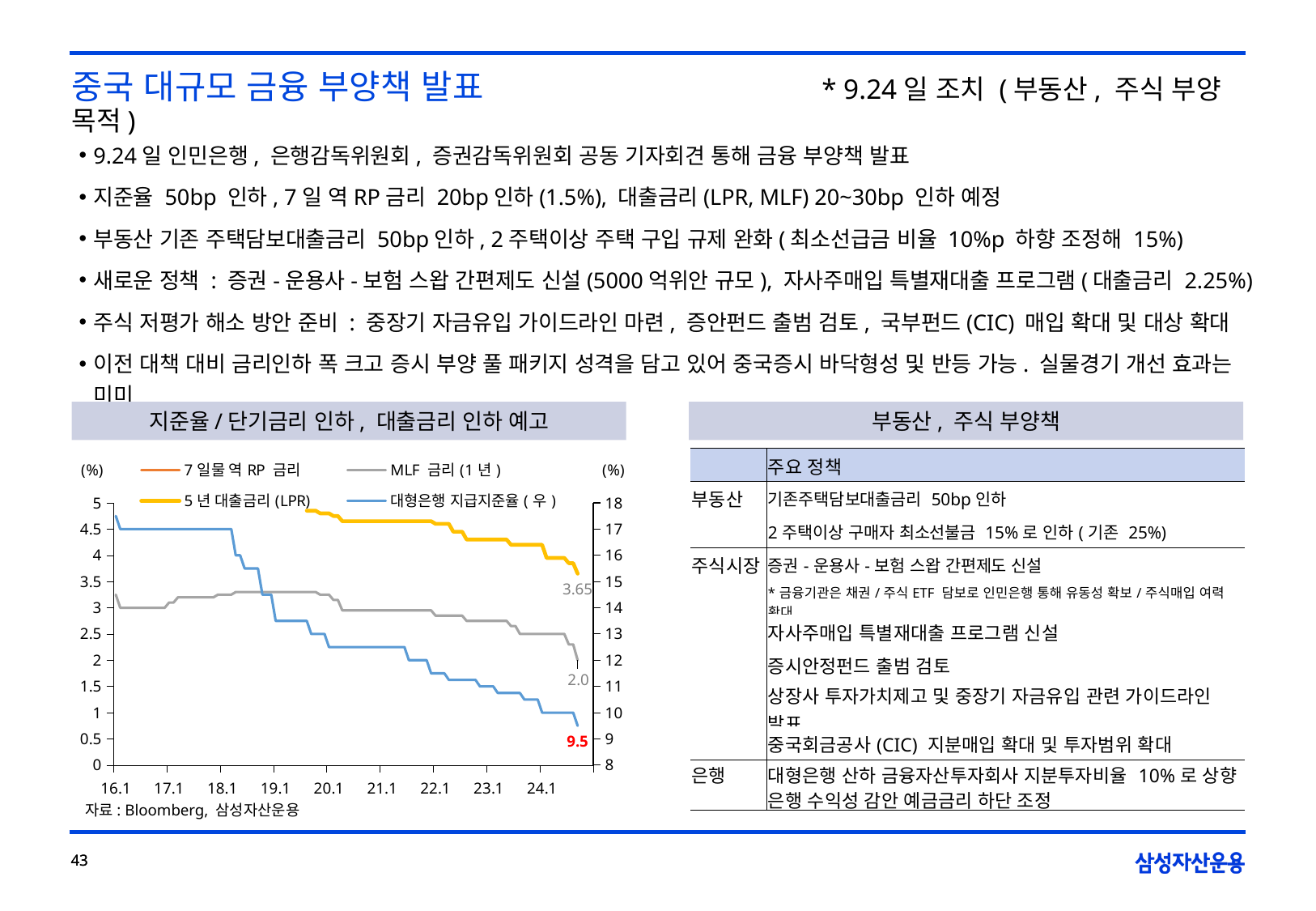
What is the latest labelled value of the MLF 금리 (1년) series? 2.0 Does the 대형은행 지급지준율 (우) series rise or fall over the period shown? fall What is the latest labelled value of the 5년 대출금리 (LPR) series? 3.65 Does the 5년 대출금리 (LPR) series rise or fall from 16.1 to 24.1? fall What kind of chart is shown on the slide? line chart What source is cited below the chart? Bloomberg, 삼성자산운용 Is the value of 대형은행 지급지준율 (우) at 16.1 greater or less than 16 on the right axis? greater Which is larger at the end of the chart, the 5년 대출금리 (LPR) or the MLF 금리 (1년)? 5년 대출금리 (LPR) How many series does the chart legend list? 4 What is the title of the chart? 지준율/단기금리 인하, 대출금리 인하 예고 What is the latest labelled value of the 대형은행 지급지준율 (우) series? 9.5 What is the difference between the latest labelled LPR value (3.65) and the latest labelled MLF value (2.0)? 1.65